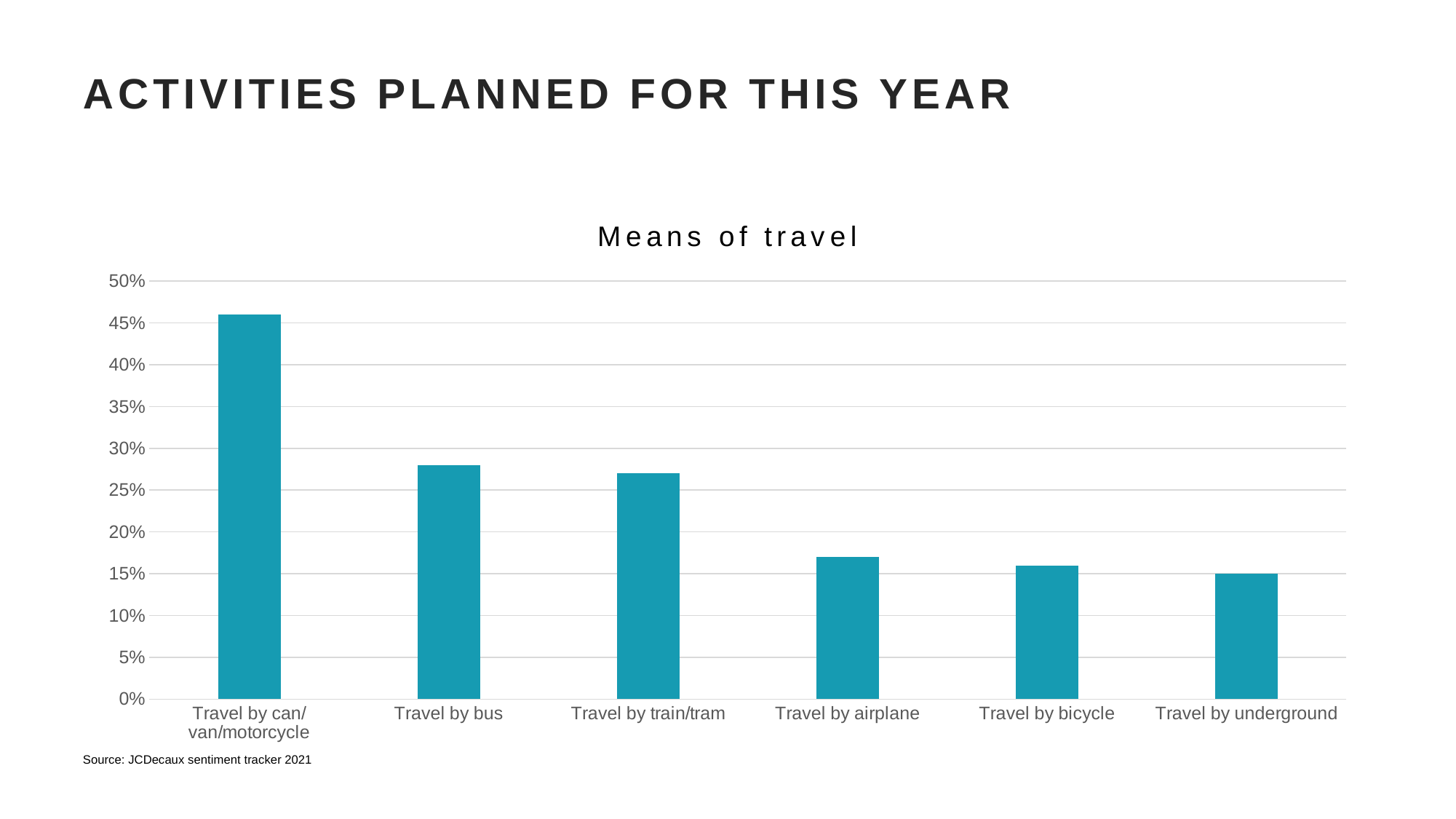
Is the value for Travel by bus greater or less than 30%? less Is the value for Travel by bus greater or less than 25%? greater How many means of travel are shown on the chart? 6 Which is larger, the value for Travel by train/tram or Travel by airplane? Travel by train/tram Is the value for Travel by underground greater or less than 20%? less What is the title of the chart? Means of travel Which means of travel has the highest value? Travel by can/van/motorcycle What type of chart is shown on the slide? bar chart Which is larger, the value for Travel by can/van/motorcycle or Travel by bus? Travel by can/van/motorcycle